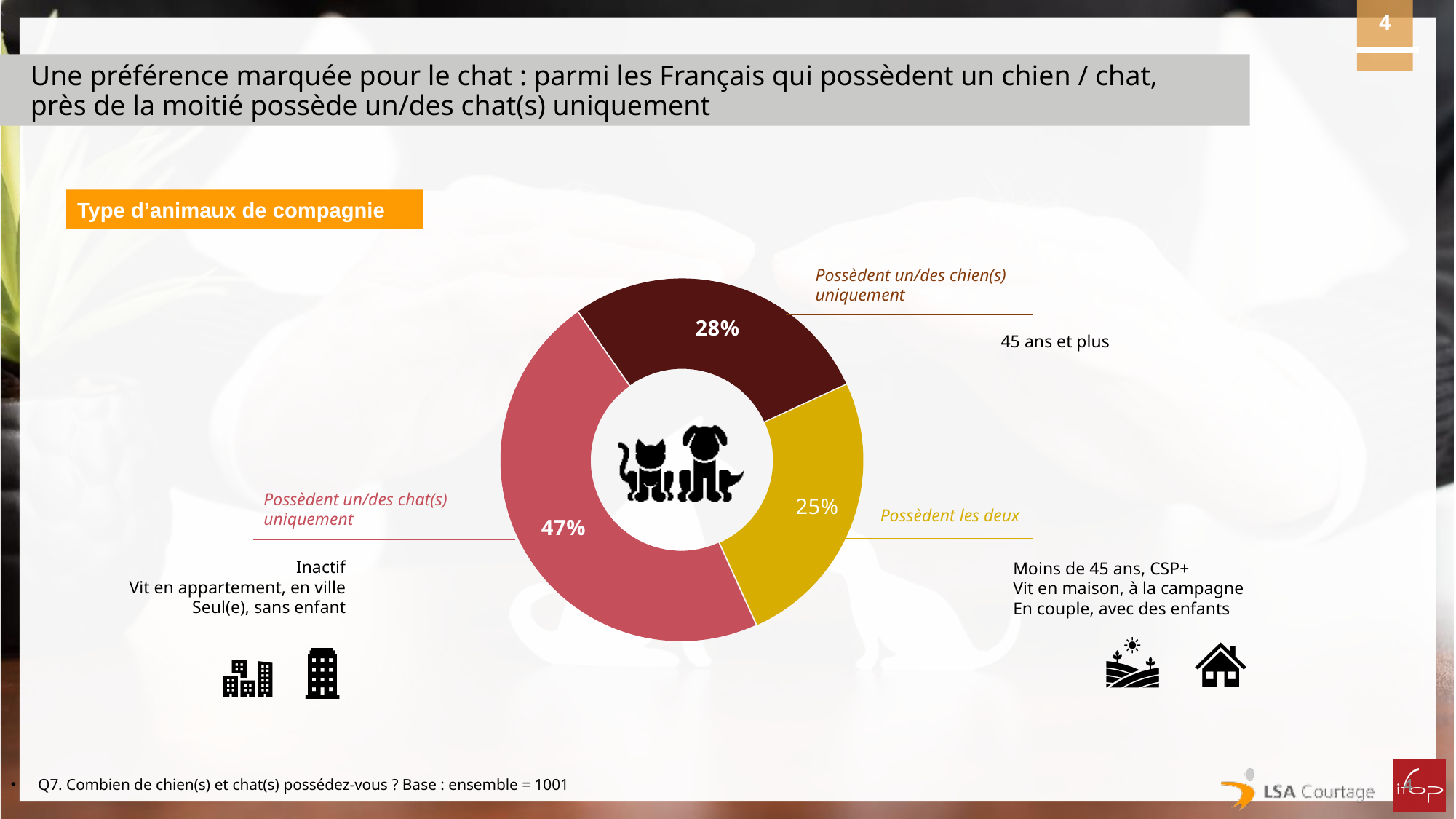
Which is larger: the share for 'Possèdent un/des chien(s) uniquement' or for 'Possèdent les deux'? Possèdent un/des chien(s) uniquement What is the difference in percentage points between 'Possèdent un/des chat(s) uniquement' and 'Possèdent un/des chien(s) uniquement'? 19 What share of the pie chart corresponds to 'Possèdent les deux'? 25% Which category has the largest share in the pie chart? Possèdent un/des chat(s) uniquement What is the difference in percentage points between 'Possèdent un/des chien(s) uniquement' and 'Possèdent les deux'? 3 What colour is the slice for 'Possèdent les deux'? Yellow What is the title shown in the orange box above the chart? Type d'animaux de compagnie How many categories does the pie chart show? 3 What kind of chart is shown on the slide? Pie chart (doughnut) What share of the pie chart corresponds to 'Possèdent un/des chat(s) uniquement'? 47% Which category has the smallest share in the pie chart? Possèdent les deux What share of the pie chart corresponds to 'Possèdent un/des chien(s) uniquement'? 28%